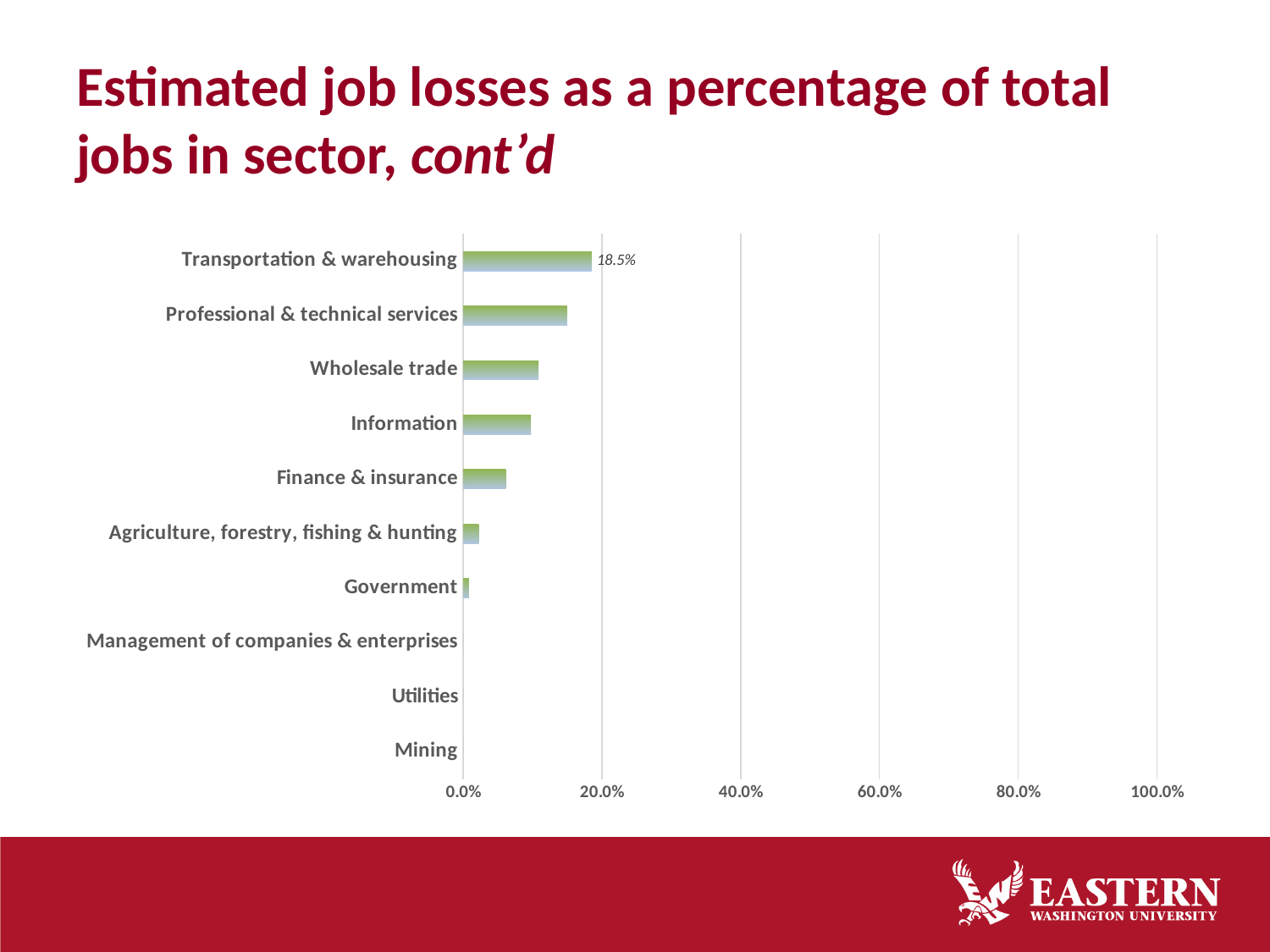
What is the value for Transportation & warehousing? 18.5% Is the value for Transportation & warehousing greater or less than 20.0%? less Which is larger, the value for Professional & technical services or the value for Wholesale trade? Professional & technical services Which is larger, the value for Finance & insurance or the value for Agriculture, forestry, fishing & hunting? Finance & insurance What kind of chart is shown on the slide? Bar chart Do the bar values rise or fall going from the top sector to the bottom sector? fall Is the value for Professional & technical services greater or less than 20.0%? less How many sectors are listed on the chart? 10 What is the highest value shown on the horizontal axis? 100.0% Is the value for Wholesale trade greater or less than 20.0%? less Which sector has the highest estimated job loss percentage? Transportation & warehousing Which is larger, the value for Information or the value for Finance & insurance? Information